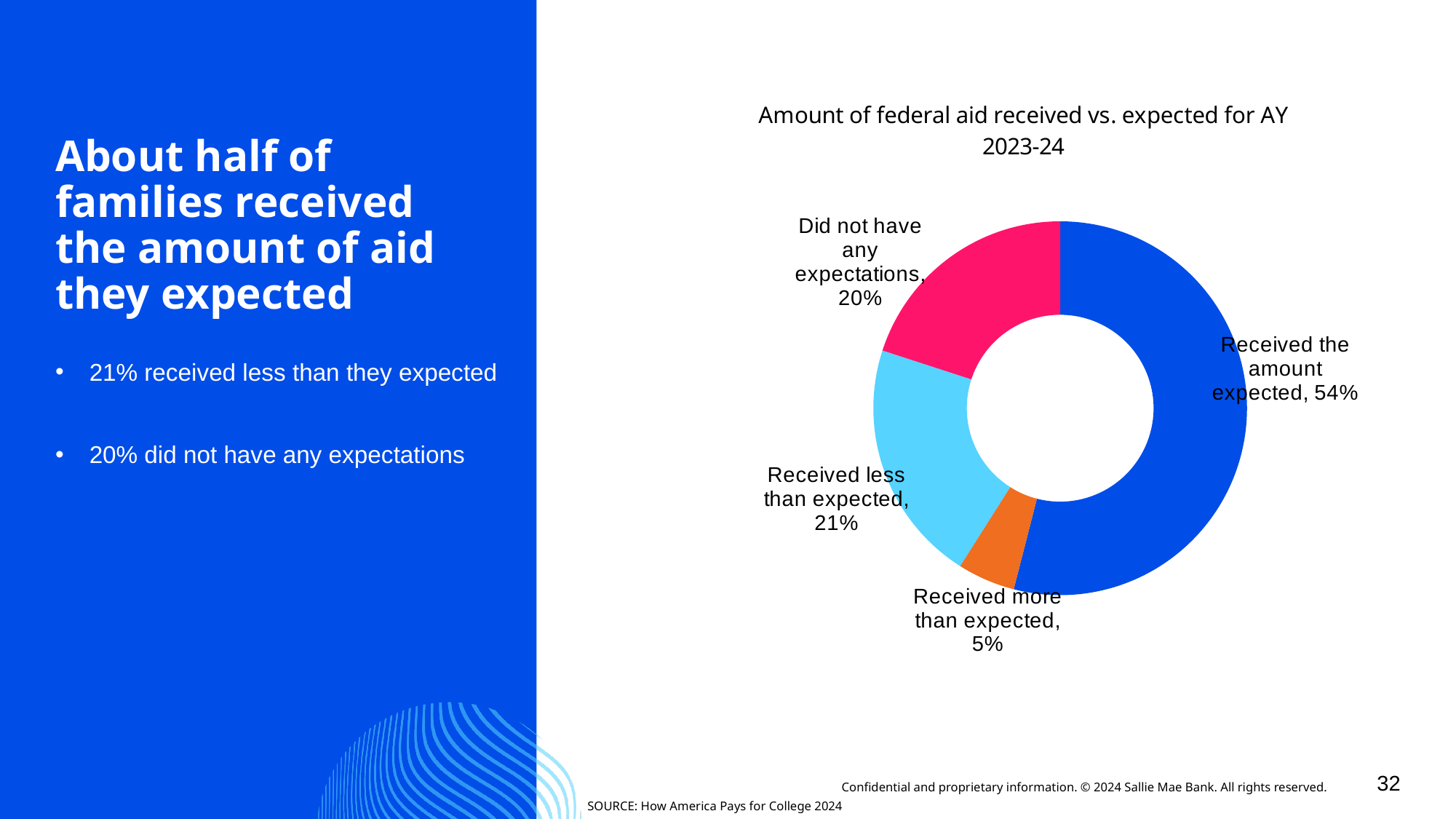
What share of families received more federal aid than expected? 5% What colour is the slice for families who received more than expected? Orange What share of families received less federal aid than expected? 21% Which category has the smallest share of the chart? Received more than expected Which is larger: the share that received less than expected or the share that received more than expected? Received less than expected What is the difference in percentage points between families who received the amount expected and those who received less than expected? 33 What share of families received the amount of federal aid they expected? 54% How many categories does the chart show? 4 What is the title of the chart? Amount of federal aid received vs. expected for AY 2023-24 What share of families did not have any expectations about federal aid? 20% What kind of chart is shown on the slide? Pie chart (doughnut) Which category has the largest share of the chart? Received the amount expected